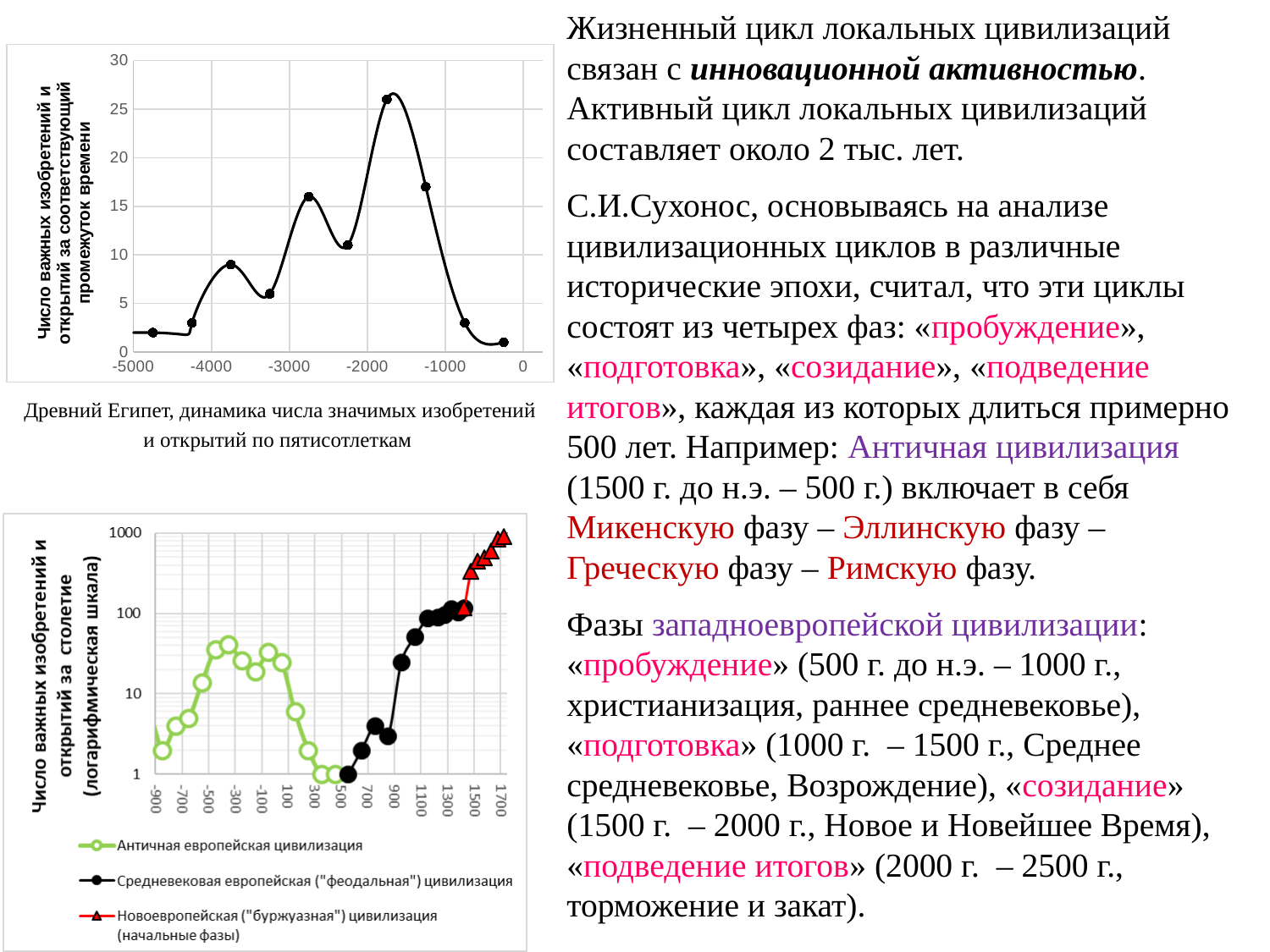
In the top chart (Древний Египет), is the peak between -3000 and -2000 greater or less than 15? greater What kind of chart is the top chart (Древний Египет)? line chart In the bottom chart, is the highest point of the Средневековая европейская ("феодальная") цивилизация series greater or less than 1000? less How many series does the legend of the bottom chart list? 3 In the top chart (Древний Египет), what is the highest tick value on the y axis? 30 In the bottom chart, do the values of the Новоевропейская ("буржуазная") цивилизация series rise or fall along the x axis? rise In the top chart (Древний Египет), is the last point (nearest to 0 on the x axis) greater or less than 5? less In the top chart (Древний Египет), how many data points are plotted? 10 In the bottom chart, which series reaches the highest values? Новоевропейская ("буржуазная") цивилизация (начальные фазы) In the bottom chart, what colour is used for the Античная европейская цивилизация series? green